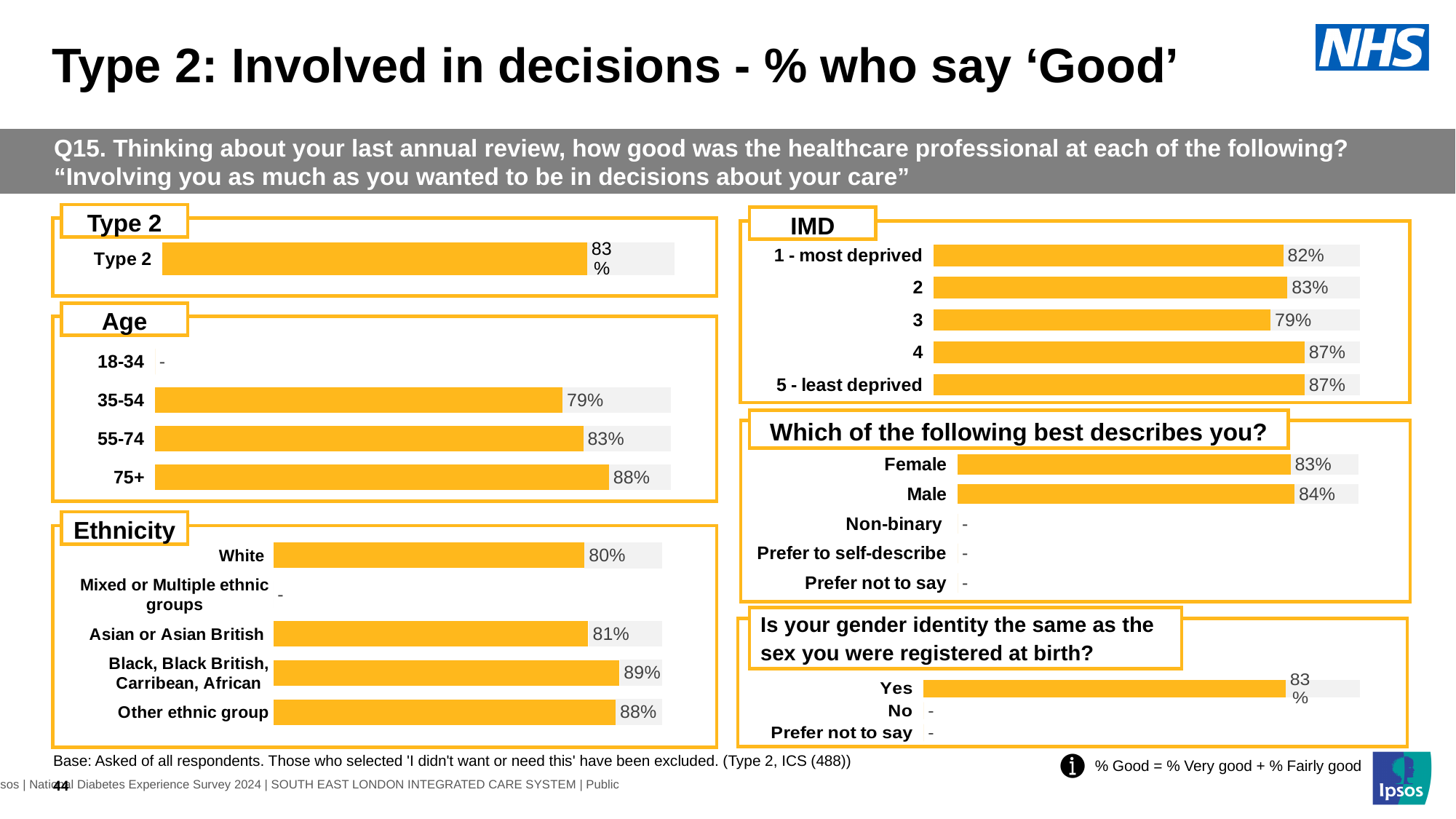
In the Ethnicity chart, what is the difference between Other ethnic group and White? 8 percentage points What type of chart is the Age chart? Bar chart In the IMD chart, what is the difference between 4 and 1 - most deprived? 5 percentage points In the Age chart, which age group with a plotted value has the lowest value? 35-54 In the IMD chart, what is the value for 3? 79% In the Type 2 chart, what is the value for Type 2? 83% In the 'Which of the following best describes you?' chart, which is larger, Female or Male? Male In the Ethnicity chart, which category has the highest value? Black, Black British, Carribean, African In the 'Is your gender identity the same as the sex you were registered at birth?' chart, what is the value for Yes? 83% How many categories are listed in the IMD chart? 5 In the Age chart, what is the value for 75+? 88% In the Ethnicity chart, what is the value for Asian or Asian British? 81%